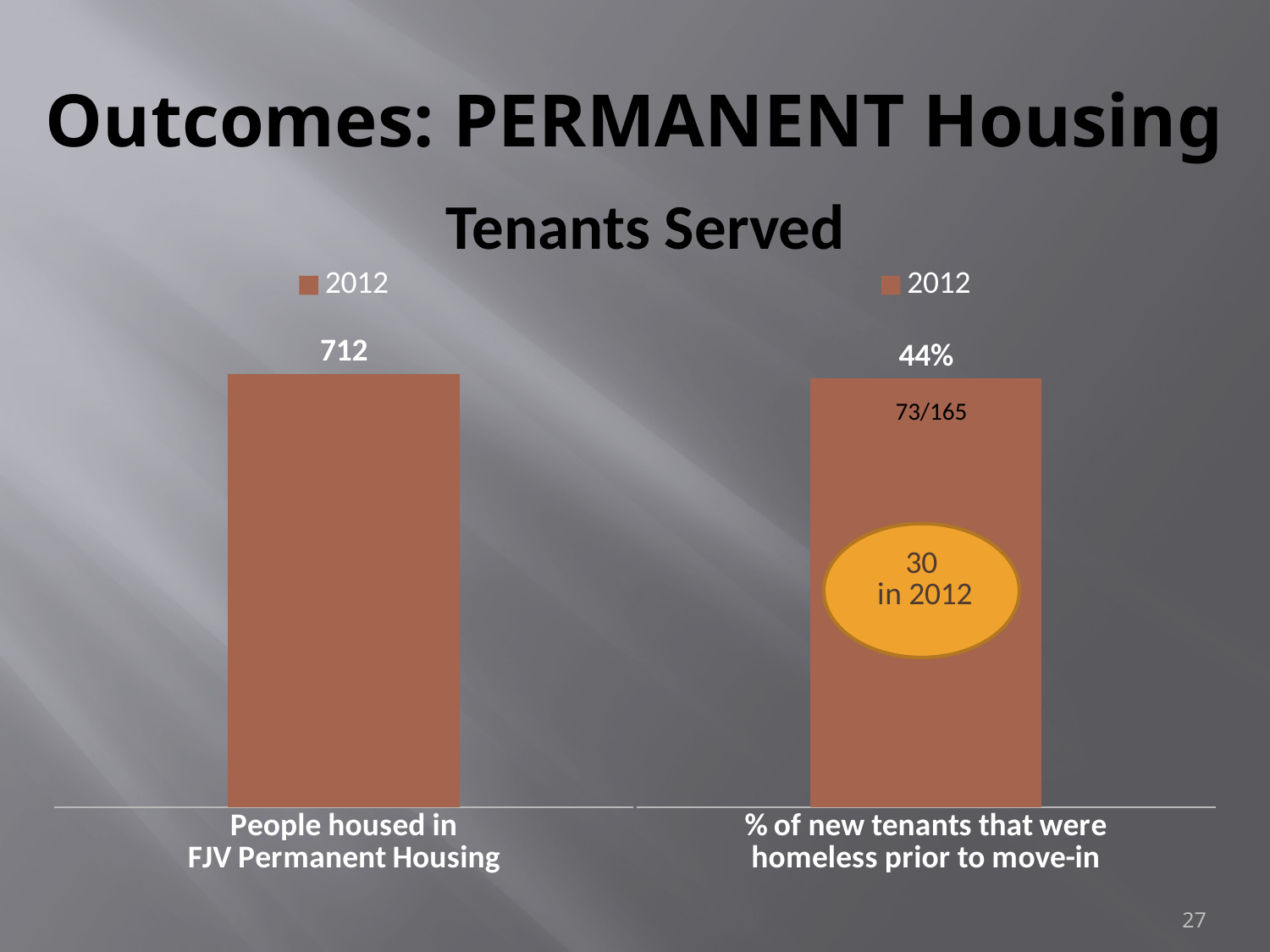
In the right chart, what is the value for % of new tenants that were homeless prior to move-in? 44% How many bars are plotted in the left chart? 1 What text is written inside the orange oval on the right chart's bar? 30 in 2012 How many series does the legend of the right chart list? 1 How many series does the legend of the left chart list? 1 What kind of chart is the left chart? bar chart What year does the legend of the left chart show? 2012 How many bars are plotted in the right chart? 1 In the left chart, what is the value for People housed in FJV Permanent Housing? 712 In the right chart, what fraction is printed inside the bar below the 44% label? 73/165 What kind of chart is the right chart? bar chart